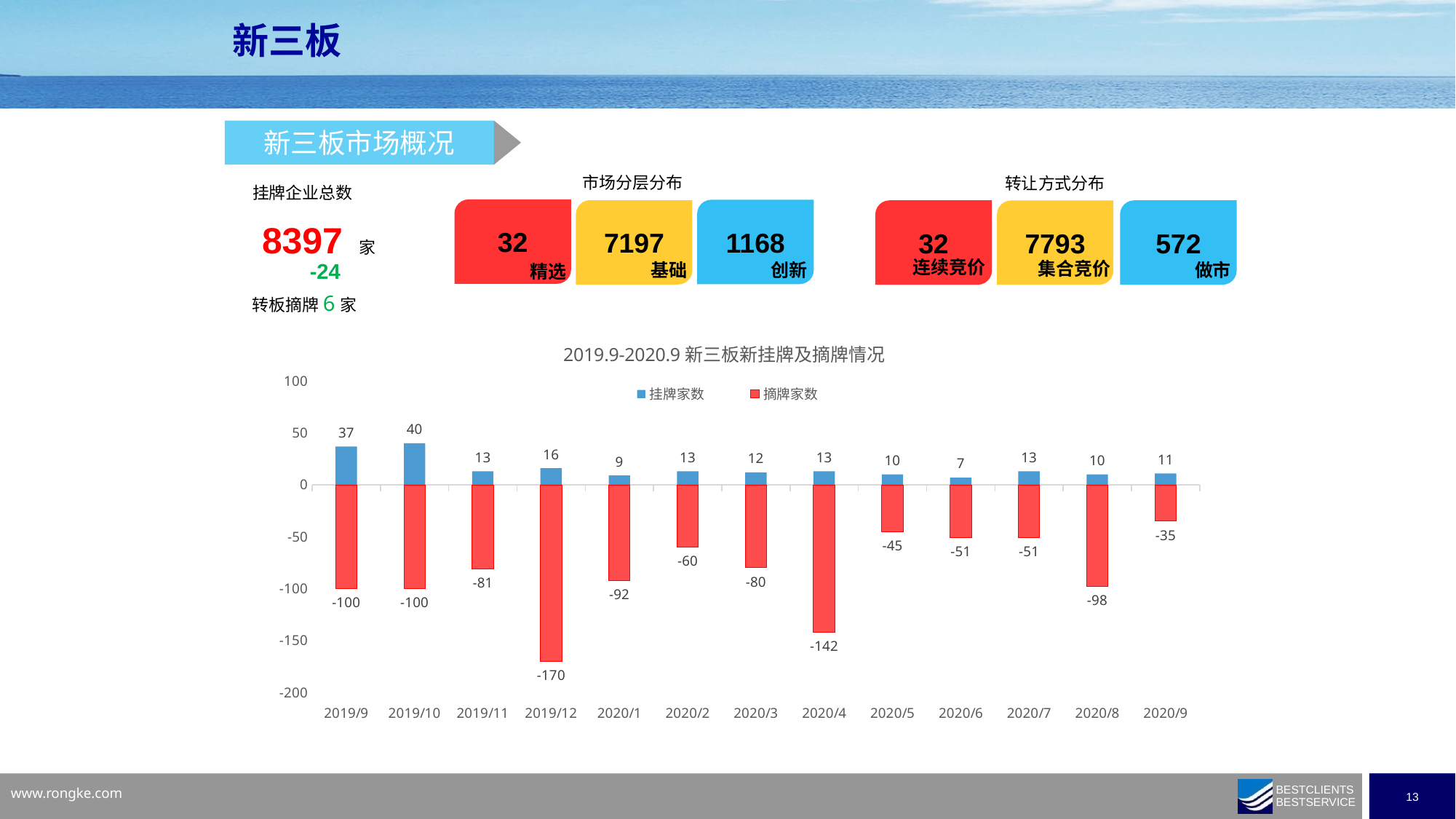
What kind of chart is shown on the slide? bar chart Which is larger, the 挂牌家数 for 2019/12 or for 2020/1? 2019/12 How many series does the chart legend list? 2 What is the 摘牌家数 value for 2020/4? -142 What is the title of the chart on the slide? 2019.9-2020.9 新三板新挂牌及摘牌情况 Which month has the lowest 摘牌家数 value (the largest number of delistings)? 2019/12 What is the 挂牌家数 value for 2019/10? 40 How many months are shown on the x axis of the chart? 13 Which colour represents 摘牌家数 in the chart? red Which month has the lowest 挂牌家数? 2020/6 What is the difference between the 挂牌家数 values for 2019/9 and 2020/9? 26 Which month has the highest 挂牌家数? 2019/10